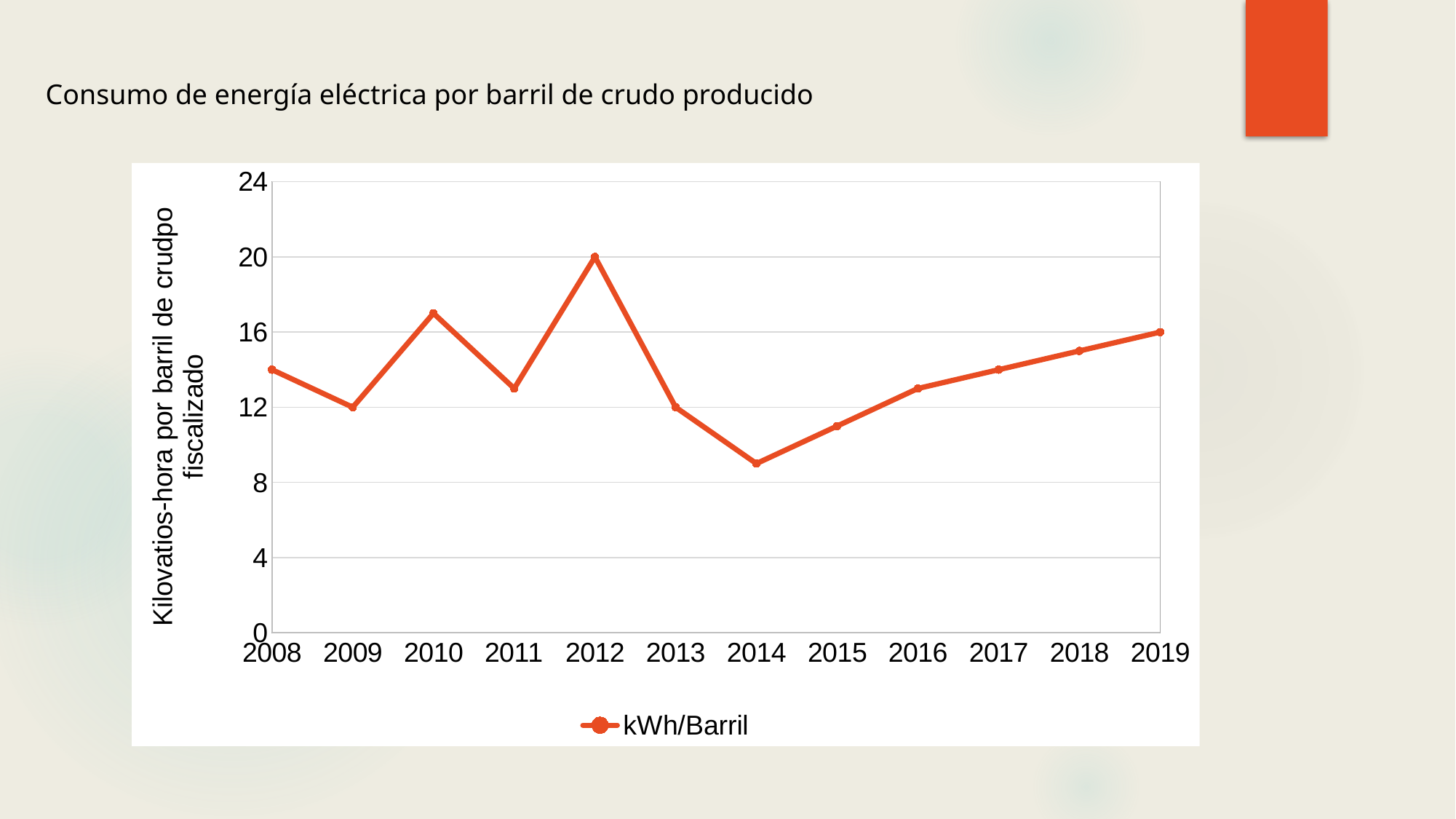
What is the difference between the kWh/Barril values for 2012 and 2013? 8 What type of chart is shown on the slide? Line chart Which year has the highest kWh/Barril value? 2012 What is the kWh/Barril value for 2012? 20 What is the kWh/Barril value for 2019? 16 Is the kWh/Barril value for 2014 greater or less than 12? less Which year has the lowest kWh/Barril value? 2014 Do the kWh/Barril values rise or fall from 2014 to 2019? Rise Is the kWh/Barril value for 2010 greater or less than 16? greater Which year has a larger kWh/Barril value, 2010 or 2011? 2010 How many years are shown on the x axis? 12 What is the kWh/Barril value for 2009? 12